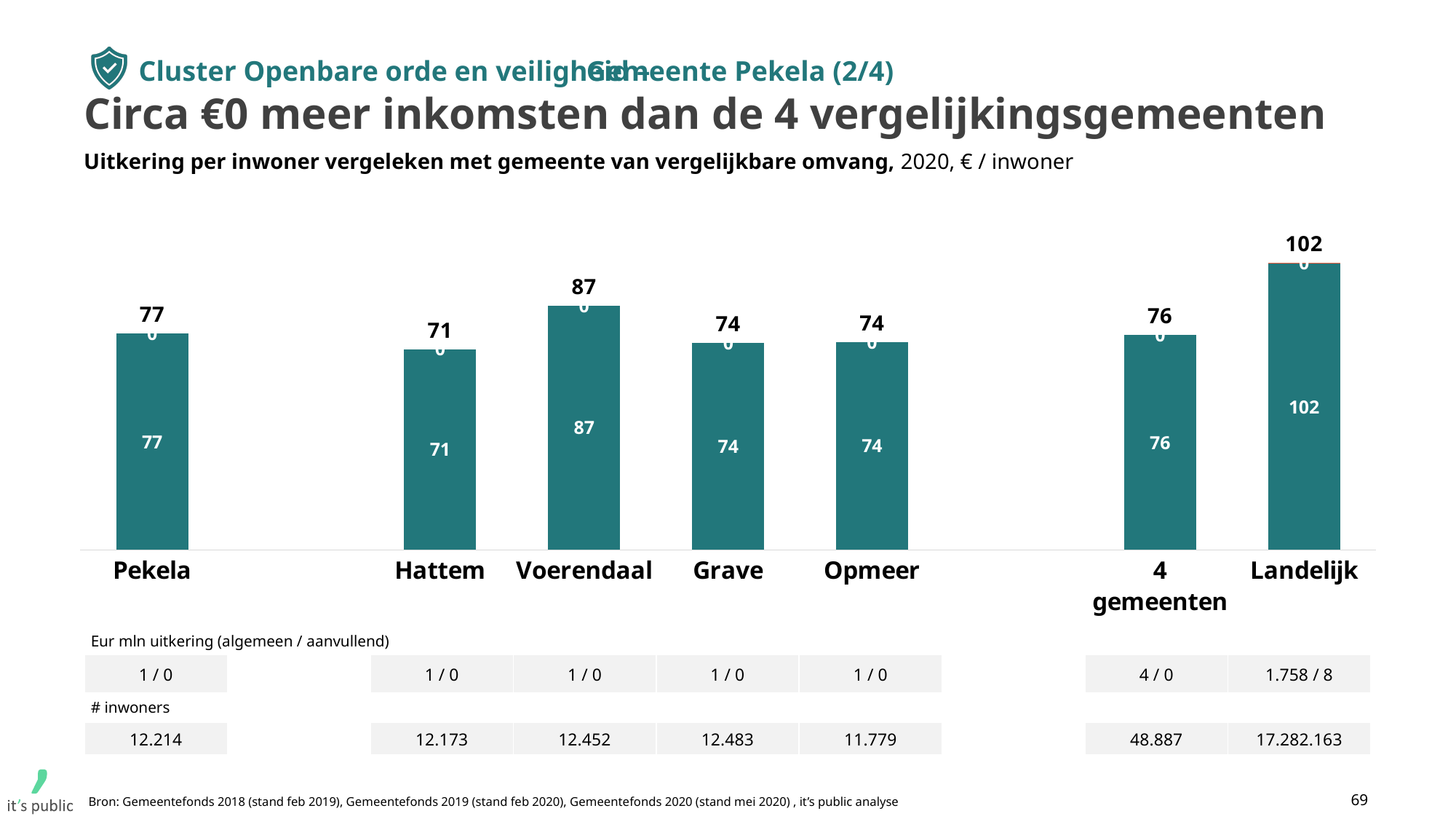
What is the difference between the values for Voerendaal and Hattem? 16 What is the value for Voerendaal? 87 Which category has the lowest value? Hattem What kind of chart is shown on the slide? bar chart What is the value for 4 gemeenten? 76 How many categories are shown on the x axis? 7 What is the difference between the values for Landelijk and Pekela? 25 What is the value for Pekela? 77 Which category has the highest value? Landelijk What is the value for Landelijk? 102 Which is larger, the value for Pekela or the value for 4 gemeenten? Pekela What is the unit stated in the chart subtitle? € / inwoner